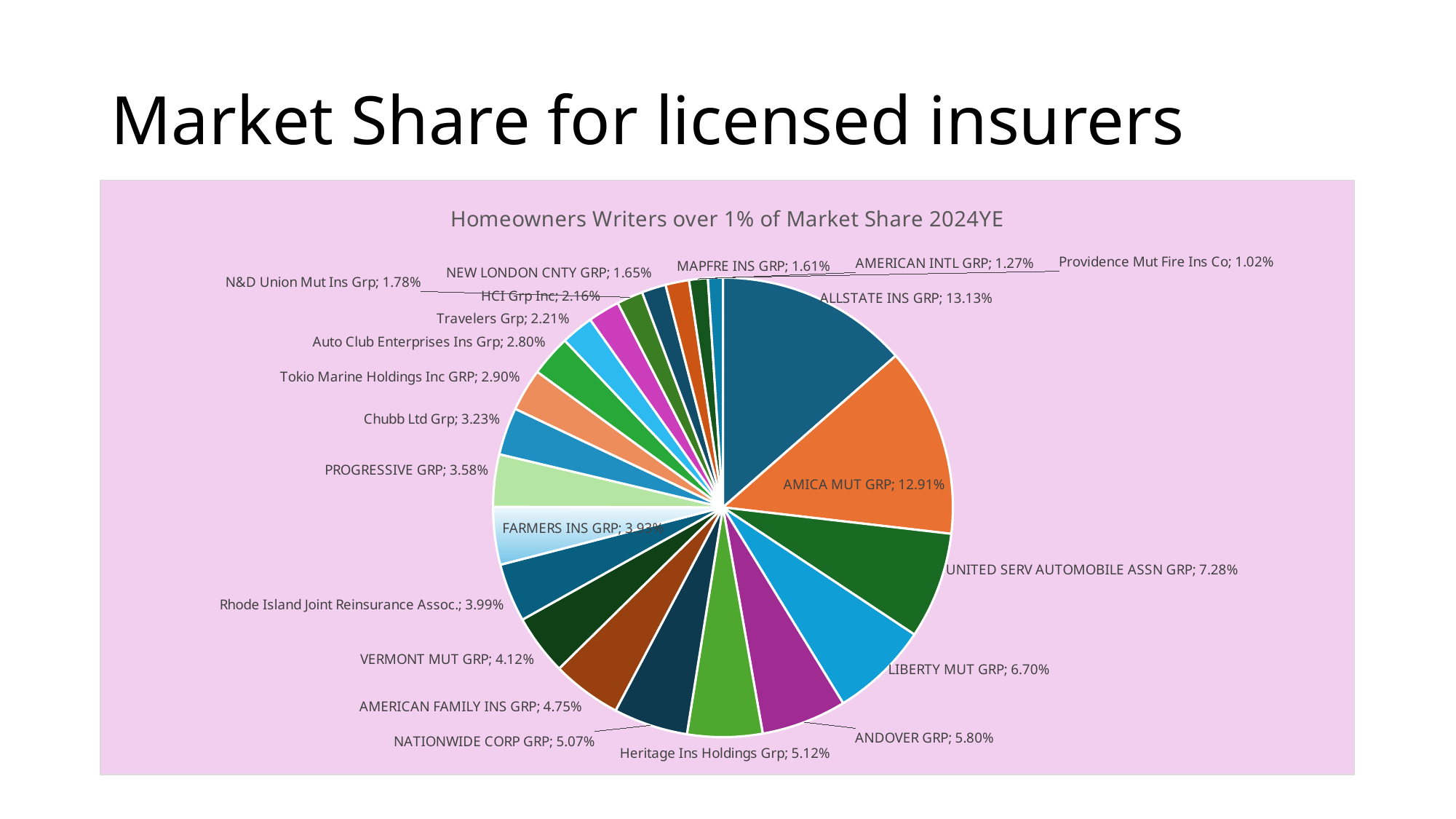
What is the market share for ALLSTATE INS GRP? 13.13% What is the market share for Chubb Ltd Grp? 3.23% Which insurer has the largest market share? ALLSTATE INS GRP Which insurer has the smallest market share? Providence Mut Fire Ins Co What is the market share for Providence Mut Fire Ins Co? 1.02% How many insurers are shown in the pie chart? 22 What is the title of the chart? Homeowners Writers over 1% of Market Share 2024YE What is the market share for LIBERTY MUT GRP? 6.70% What type of chart is shown on the slide? pie chart What is the difference in market share between UNITED SERV AUTOMOBILE ASSN GRP and LIBERTY MUT GRP? 0.58% Which has a larger market share, ANDOVER GRP or Heritage Ins Holdings Grp? ANDOVER GRP What is the difference in market share between ALLSTATE INS GRP and AMICA MUT GRP? 0.22%